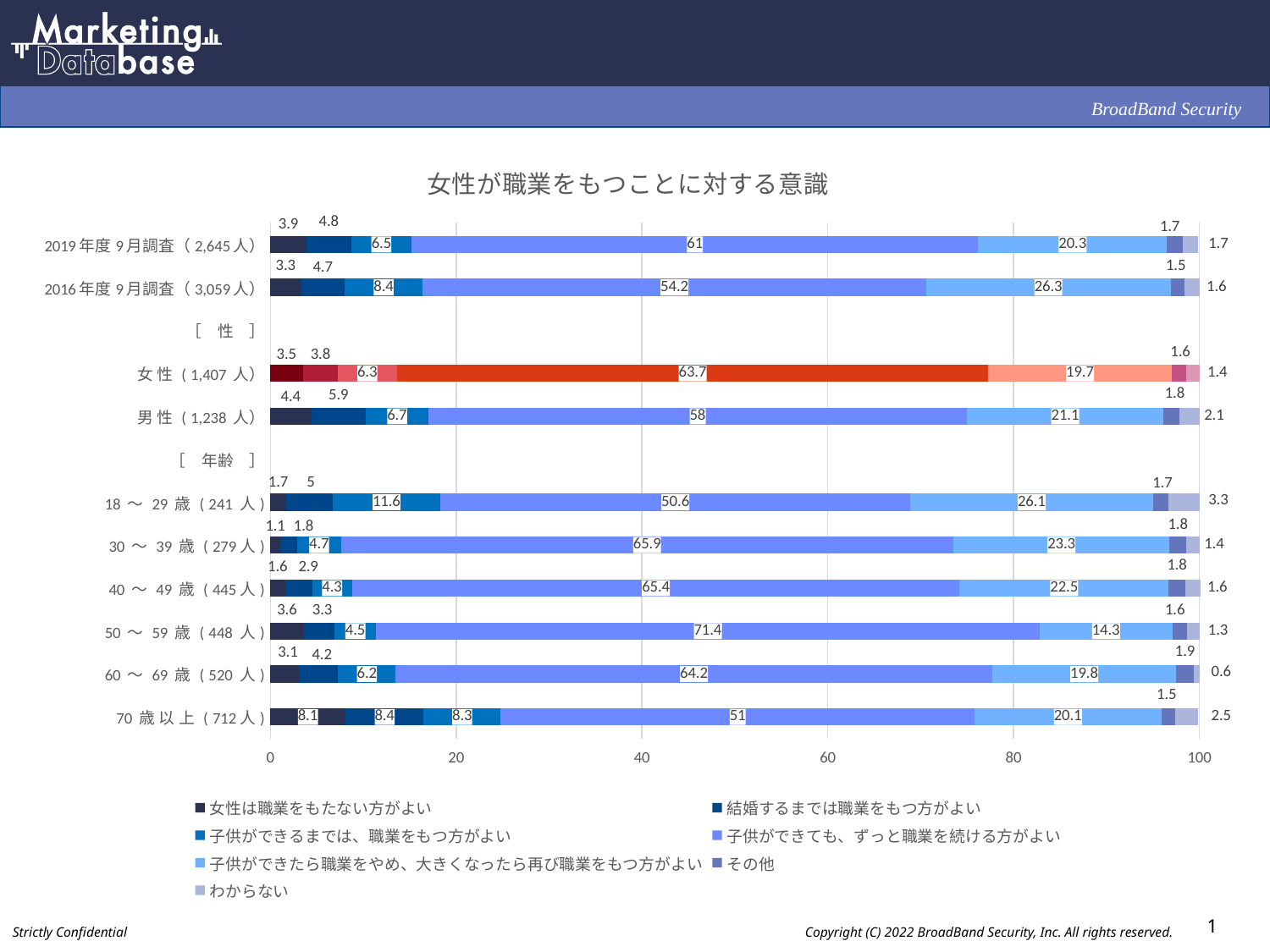
What is the title of the chart? 女性が職業をもつことに対する意識 Which is larger for 子供ができるまでは、職業をもつ方がよい: 18〜29歳 or 30〜39歳? 18〜29歳 What is the value for 子供ができても、ずっと職業を続ける方がよい in the 2016年度9月調査 bar? 54.2 Which age group has the highest value for 子供ができても、ずっと職業を続ける方がよい? 50〜59歳 Which age group has the lowest value for 子供ができても、ずっと職業を続ける方がよい? 18〜29歳 How many bars (categories) are plotted in the chart? 10 What is the value for 子供ができたら職業をやめ、大きくなったら再び職業をもつ方がよい in the 50〜59歳 bar? 14.3 What is the value for 子供ができても、ずっと職業を続ける方がよい in the 2019年度9月調査 bar? 61 What is the value for 子供ができたら職業をやめ、大きくなったら再び職業をもつ方がよい in the 女性 bar? 19.7 How many series does the legend list? 7 What kind of chart is shown on the slide? stacked bar chart What is the difference between the 女性 and 男性 values for 子供ができても、ずっと職業を続ける方がよい? 5.7